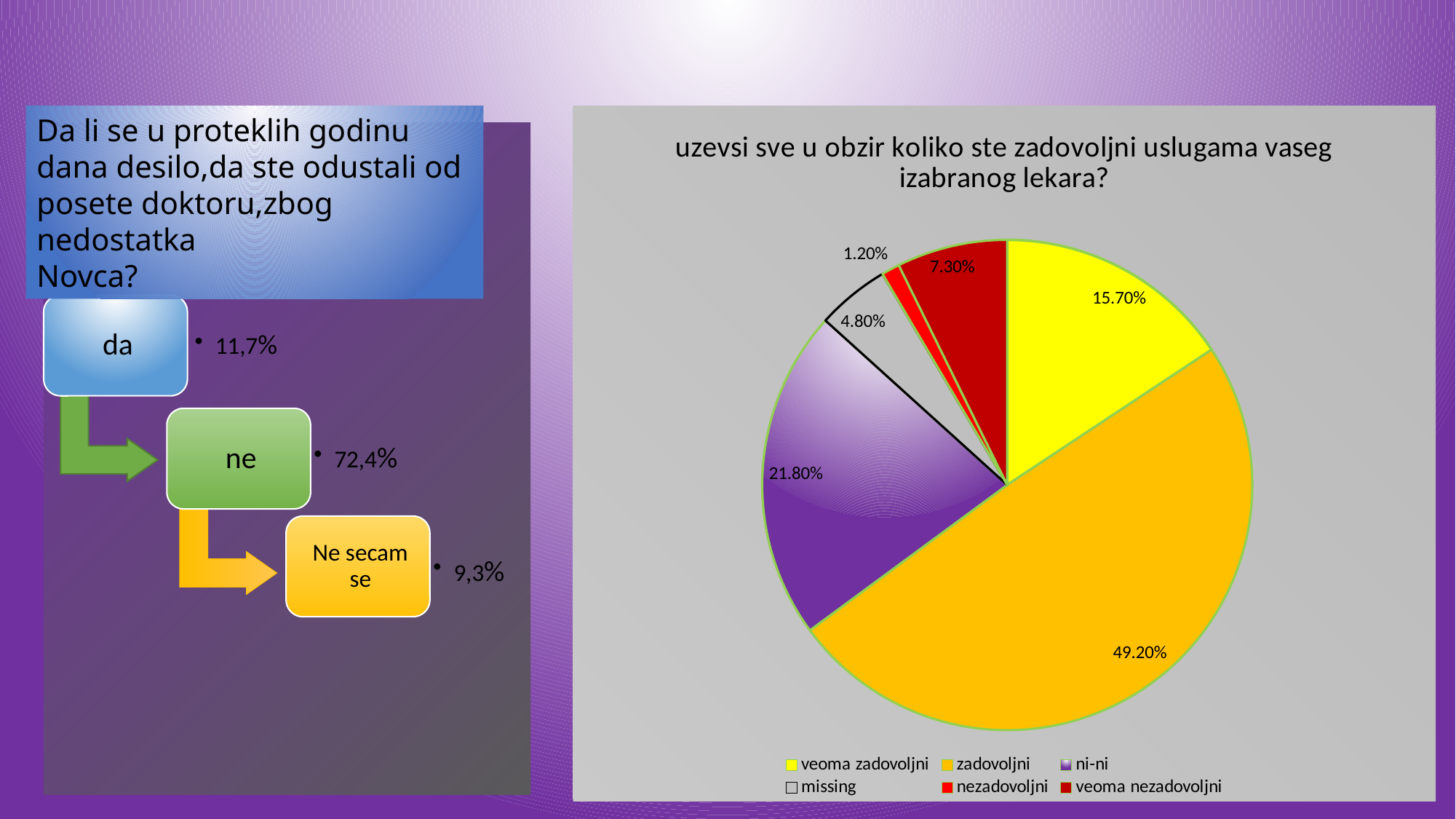
What percentage of the pie chart is 'ni-ni'? 21.80% What is the difference in percentage points between 'zadovoljni' and 'ni-ni' in the pie chart? 27.40 Which category has the smallest slice of the pie chart? nezadovoljni What kind of chart is shown on the slide? pie chart What percentage of the pie chart is 'missing'? 4.80% How many categories does the pie chart legend list? 6 Which category has the largest slice of the pie chart? zadovoljni What percentage of the pie chart is 'veoma nezadovoljni'? 7.30% What is the title of the pie chart? uzevsi sve u obzir koliko ste zadovoljni uslugama vaseg izabranog lekara? Which is larger in the pie chart, 'veoma zadovoljni' or 'veoma nezadovoljni'? veoma zadovoljni What percentage of the pie chart is 'veoma zadovoljni'? 15.70% What percentage of the pie chart is 'zadovoljni'? 49.20%